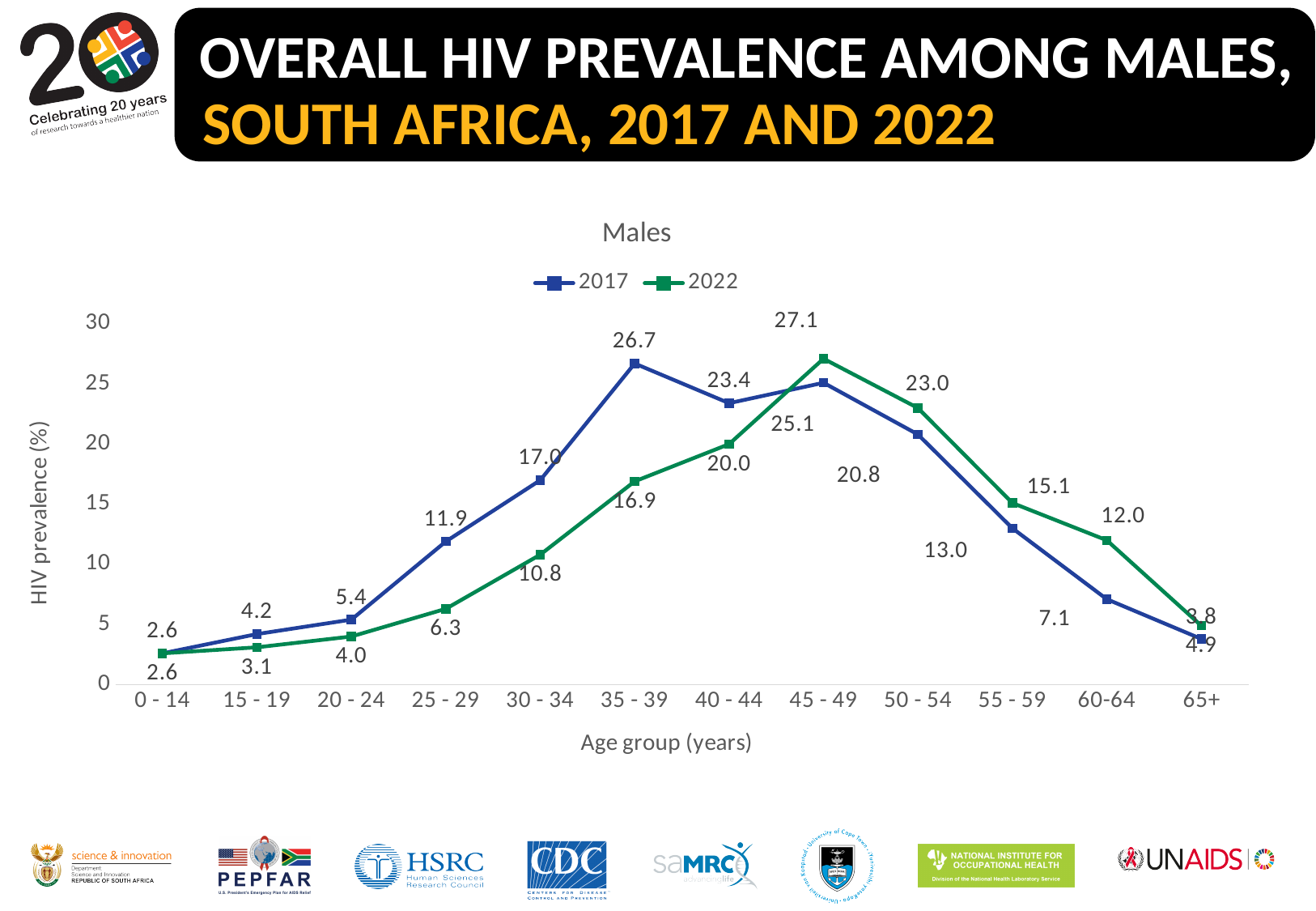
Which age group has the highest HIV prevalence in the 2022 series? 45 - 49 What is the HIV prevalence for males aged 45 - 49 in 2022? 27.1 What is the HIV prevalence for males aged 30 - 34 in 2022? 10.8 Does the 2017 series rise or fall from the 45 - 49 age group to the 60-64 age group? Fall What type of chart is shown on the slide? Line chart Which age group has the highest HIV prevalence in the 2017 series? 35 - 39 For the 50 - 54 age group, which year has the higher HIV prevalence, 2017 or 2022? 2022 What is the difference between the 2017 and 2022 values for the 35 - 39 age group? 9.8 What is the label on the vertical axis of the chart? HIV prevalence (%) How many age groups are shown on the x axis? 12 How many series does the legend list? 2 What is the HIV prevalence for males aged 35 - 39 in 2017? 26.7